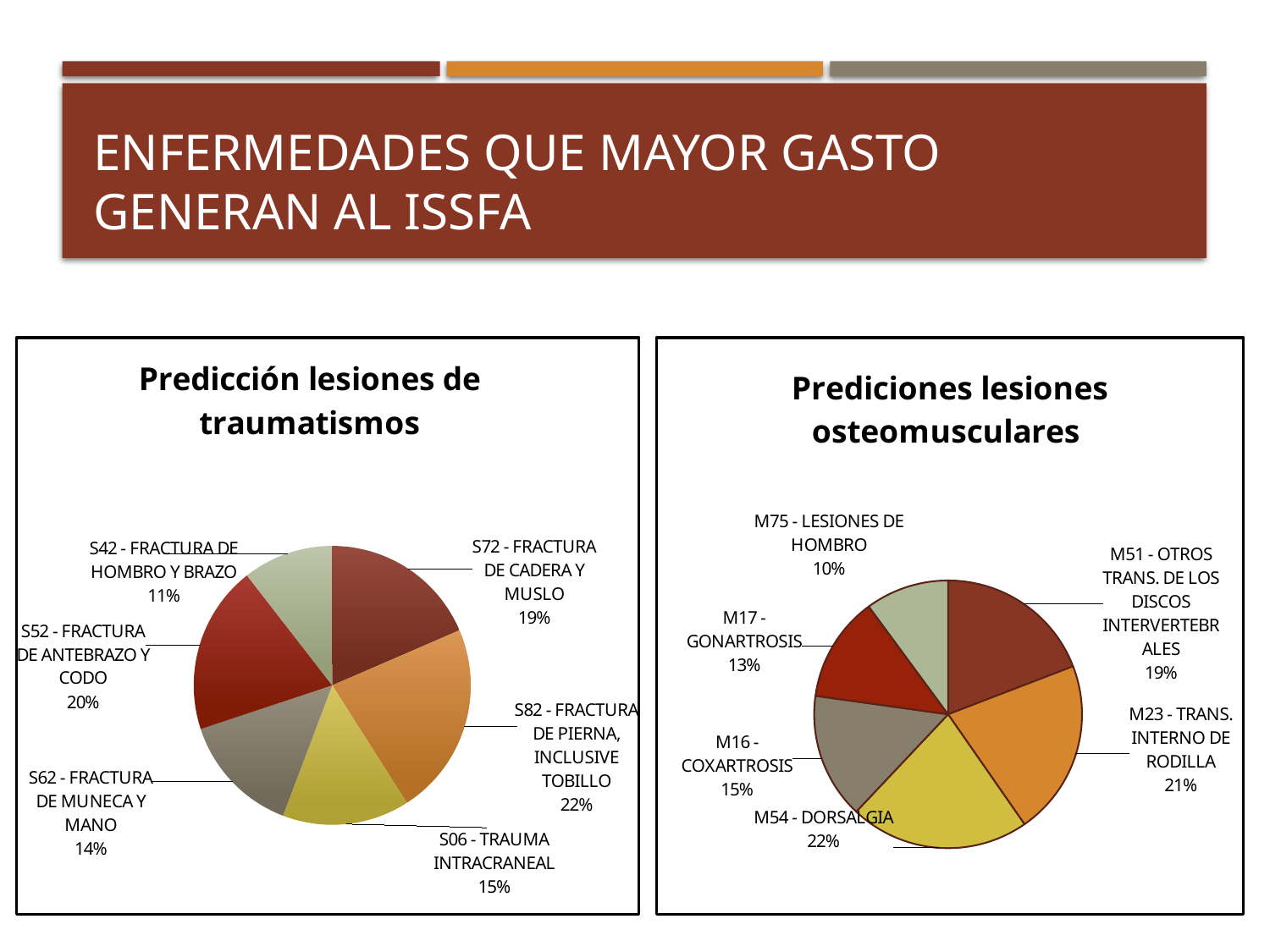
In the 'Prediciones lesiones osteomusculares' chart, which category has the smallest slice? M75 - LESIONES DE HOMBRO In the 'Predicción lesiones de traumatismos' chart, how many categories are shown? 6 In the 'Predicción lesiones de traumatismos' chart, which category has the smallest slice? S42 - FRACTURA DE HOMBRO Y BRAZO In the 'Predicción lesiones de traumatismos' chart, what is the difference between the shares of S72 - FRACTURA DE CADERA Y MUSLO and S62 - FRACTURA DE MUNECA Y MANO? 5% In the 'Prediciones lesiones osteomusculares' chart, what share does M17 - GONARTROSIS have? 13% In the 'Prediciones lesiones osteomusculares' chart, what share does M54 - DORSALGIA have? 22% In the 'Predicción lesiones de traumatismos' chart, what share does S52 - FRACTURA DE ANTEBRAZO Y CODO have? 20% What is the title of the chart on the left side of the slide? Predicción lesiones de traumatismos In the 'Prediciones lesiones osteomusculares' chart, which is larger: M23 - TRANS. INTERNO DE RODILLA or M16 - COXARTROSIS? M23 - TRANS. INTERNO DE RODILLA In the 'Predicción lesiones de traumatismos' chart, which category has the largest slice? S82 - FRACTURA DE PIERNA, INCLUSIVE TOBILLO What type of chart is the 'Prediciones lesiones osteomusculares' chart? Pie chart